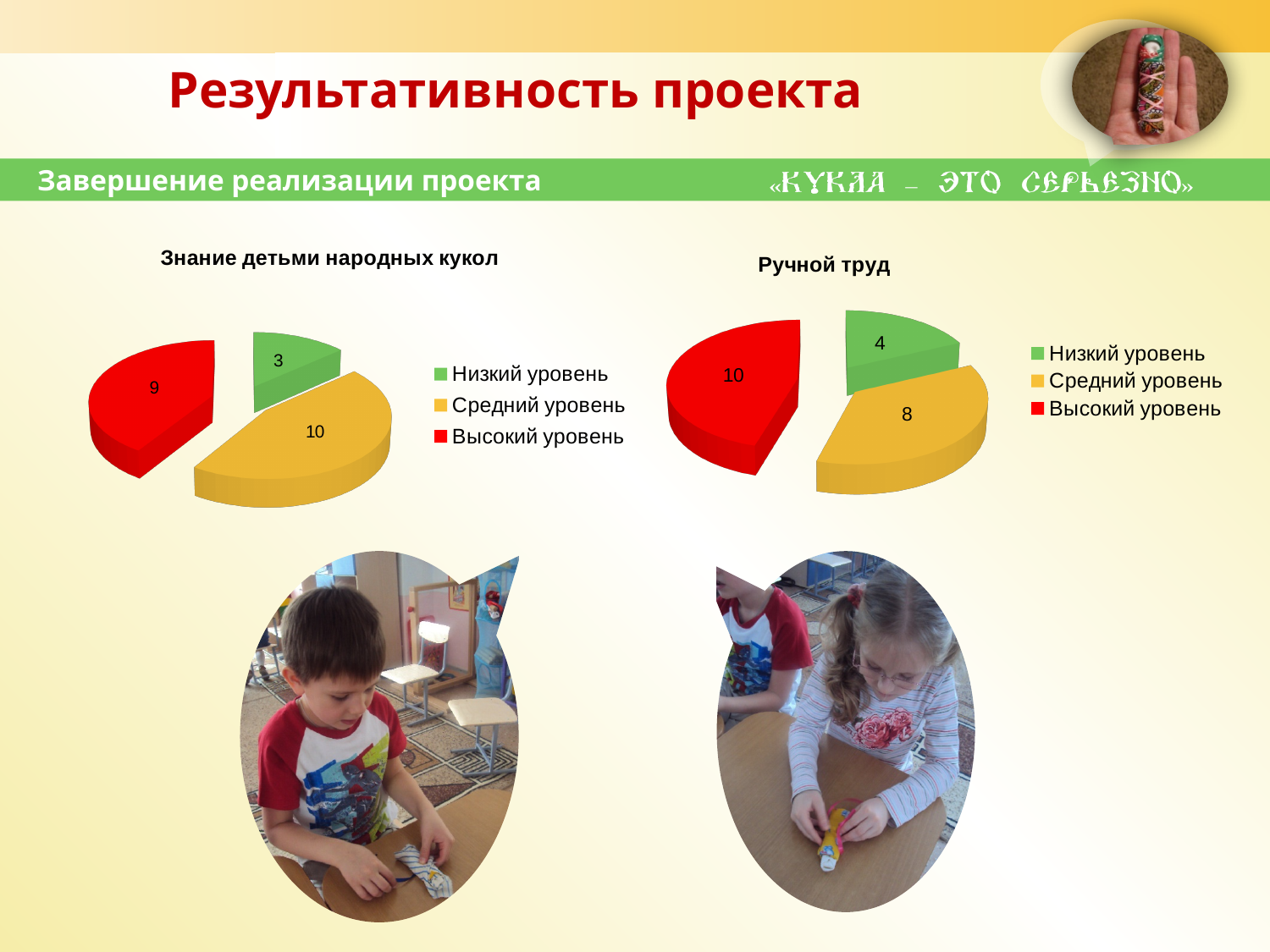
In the chart titled "Знание детьми народных кукол", what colour is the slice for Высокий уровень? Red In the chart titled "Ручной труд", what is the value for Средний уровень? 8 How many entries does the legend of the chart titled "Знание детьми народных кукол" list? 3 In the chart titled "Знание детьми народных кукол", what is the value for Низкий уровень? 3 What kind of chart is the chart titled "Ручной труд"? Pie chart In the chart titled "Ручной труд", what is the difference between the values for Высокий уровень and Низкий уровень? 6 In the chart titled "Ручной труд", which category has the largest value? Высокий уровень In the chart titled "Ручной труд", what is the value for Высокий уровень? 10 In the chart titled "Знание детьми народных кукол", which category has the smallest value? Низкий уровень In the chart titled "Знание детьми народных кукол", what is the value for Средний уровень? 10 How many slices does the chart titled "Ручной труд" have? 3 In the chart titled "Знание детьми народных кукол", which is larger: the value for Средний уровень or the value for Высокий уровень? Средний уровень